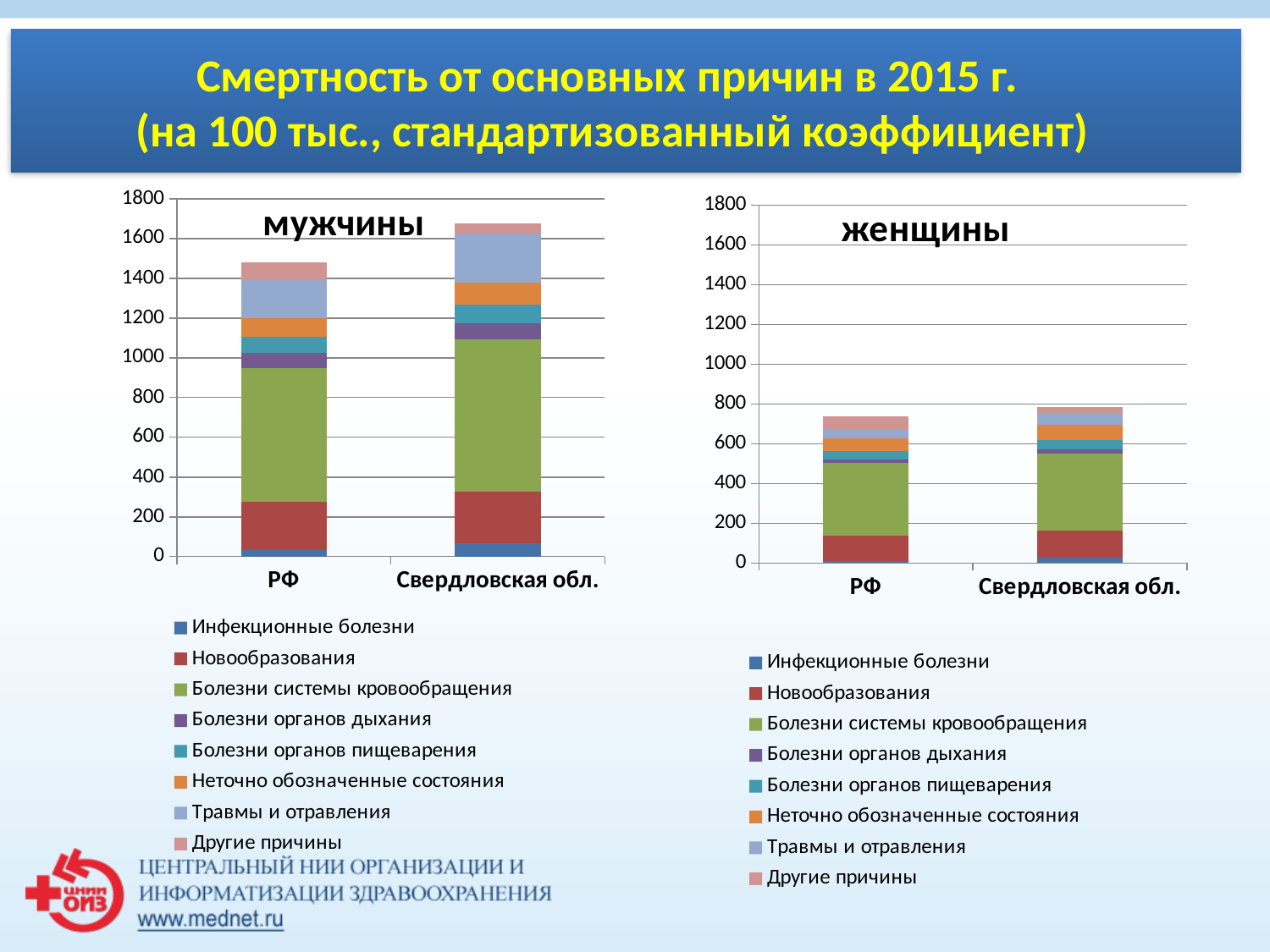
What is the highest value shown on the y axis of the "женщины" chart? 1800 In the "женщины" chart, is the total for Свердловская обл. greater or less than 600? greater In the "мужчины" chart, is the total for Свердловская обл. greater or less than 1600? greater In the "женщины" chart, which series forms the largest segment of the Свердловская обл. bar? Болезни системы кровообращения In the "мужчины" chart, which category has the taller stacked bar, РФ or Свердловская обл.? Свердловская обл. In the "мужчины" chart, is the total for РФ greater or less than 1400? greater Which series is shown in green in the legend of the "мужчины" chart? Болезни системы кровообращения What kind of chart is the "мужчины" chart? stacked bar chart How many categories are shown on the x axis of the "женщины" chart? 2 How many series does the legend of the "мужчины" chart list? 8 In the "мужчины" chart, which series forms the largest segment of the РФ bar? Болезни системы кровообращения